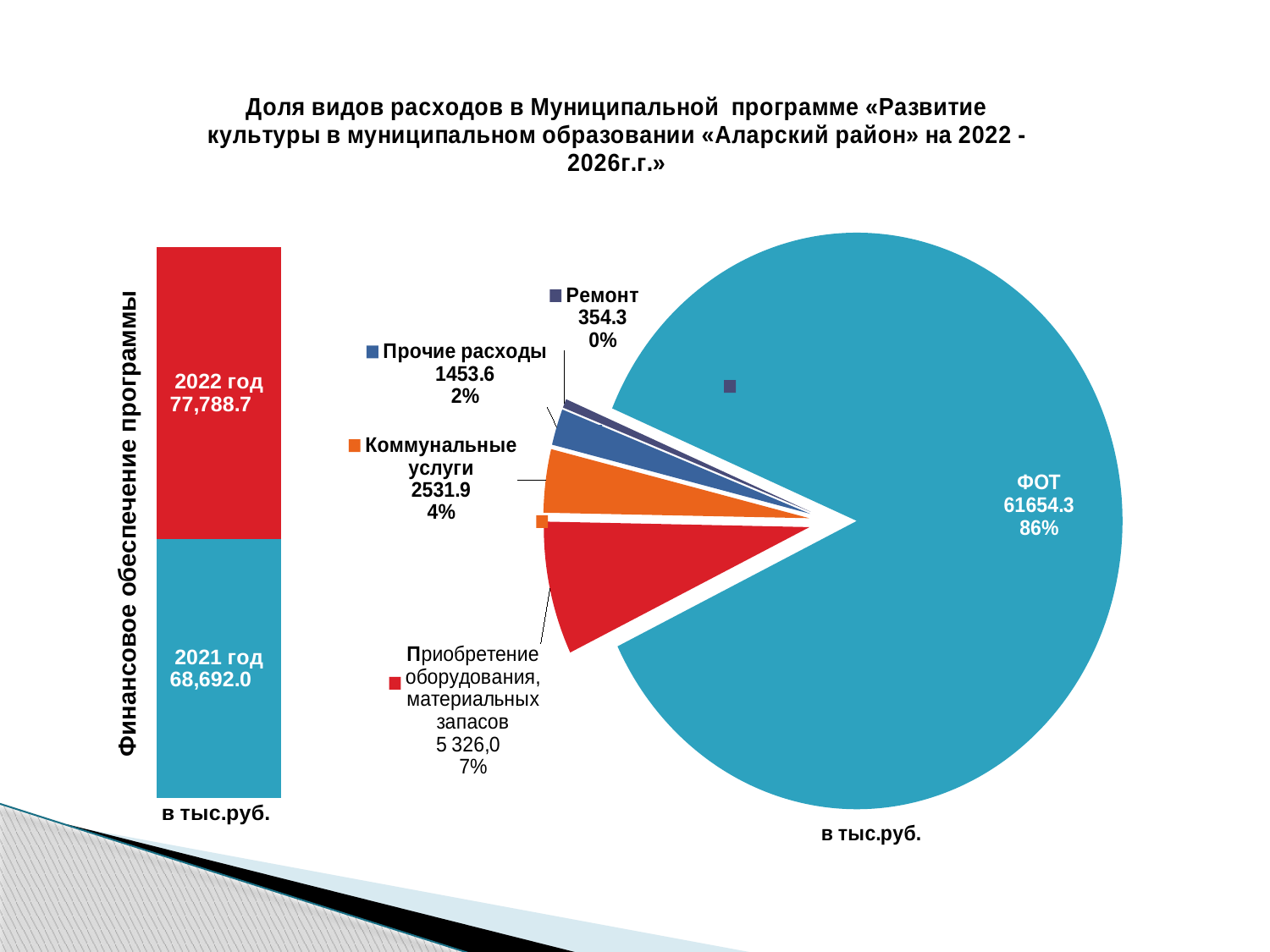
In the pie chart on the right, what share of the pie does ФОТ represent? 86% In the bar chart on the left, what is the value for 2022 год? 77,788.7 In the pie chart on the right, which category has the smallest slice? Ремонт In the pie chart on the right, how many slices are there? 5 In the pie chart on the right, which is larger: Коммунальные услуги or Прочие расходы? Коммунальные услуги In the pie chart on the right, what percentage is shown for Прочие расходы? 2% In the pie chart on the right, what is the value for Коммунальные услуги? 2531.9 In the bar chart on the left, what is the value for 2021 год? 68,692.0 In the pie chart on the right, which category has the largest slice? ФОТ What type of chart is shown on the left of the slide? Bar chart In the pie chart on the right, what is the value for ФОТ? 61654.3 In the pie chart on the right, what is the value for Ремонт? 354.3